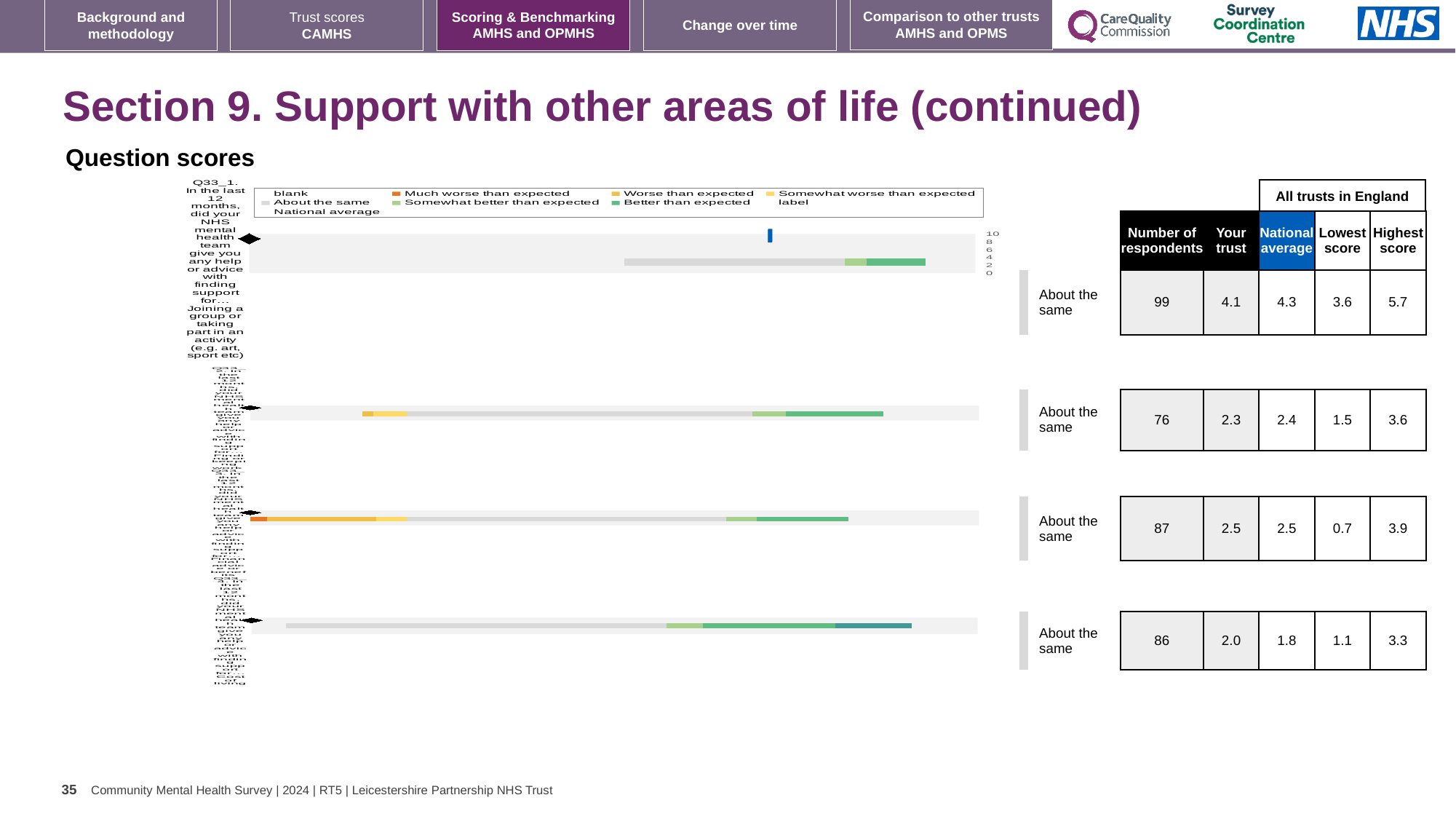
Which legend entry in the chart is shown in dark green? Better than expected In the table beside the chart, what is the national average for the first question row (Q33_1)? 4.3 In the table beside the chart, is the 'Your trust' score for the bottom row larger or smaller than its national average? larger What benchmark category label is shown to the right of the first bar in the chart? About the same How many horizontal bars (question rows) are plotted in the chart? 4 Which legend entry in the chart is shown in orange? Much worse than expected In the table beside the chart, what is the difference between the highest score and the lowest score for the first question row (Q33_1)? 2.1 In the table beside the chart, how many respondents are listed for the first question row (Q33_1)? 99 What kind of chart is shown on the slide? bar chart What benchmark category label is shown to the right of the fourth (bottom) bar in the chart? About the same In the table beside the chart, what is the 'Your trust' score for the first question row (Q33_1, joining a group or taking part in an activity)? 4.1 In the table beside the chart, which question row has the highest 'Your trust' score? the first row (Q33_1)